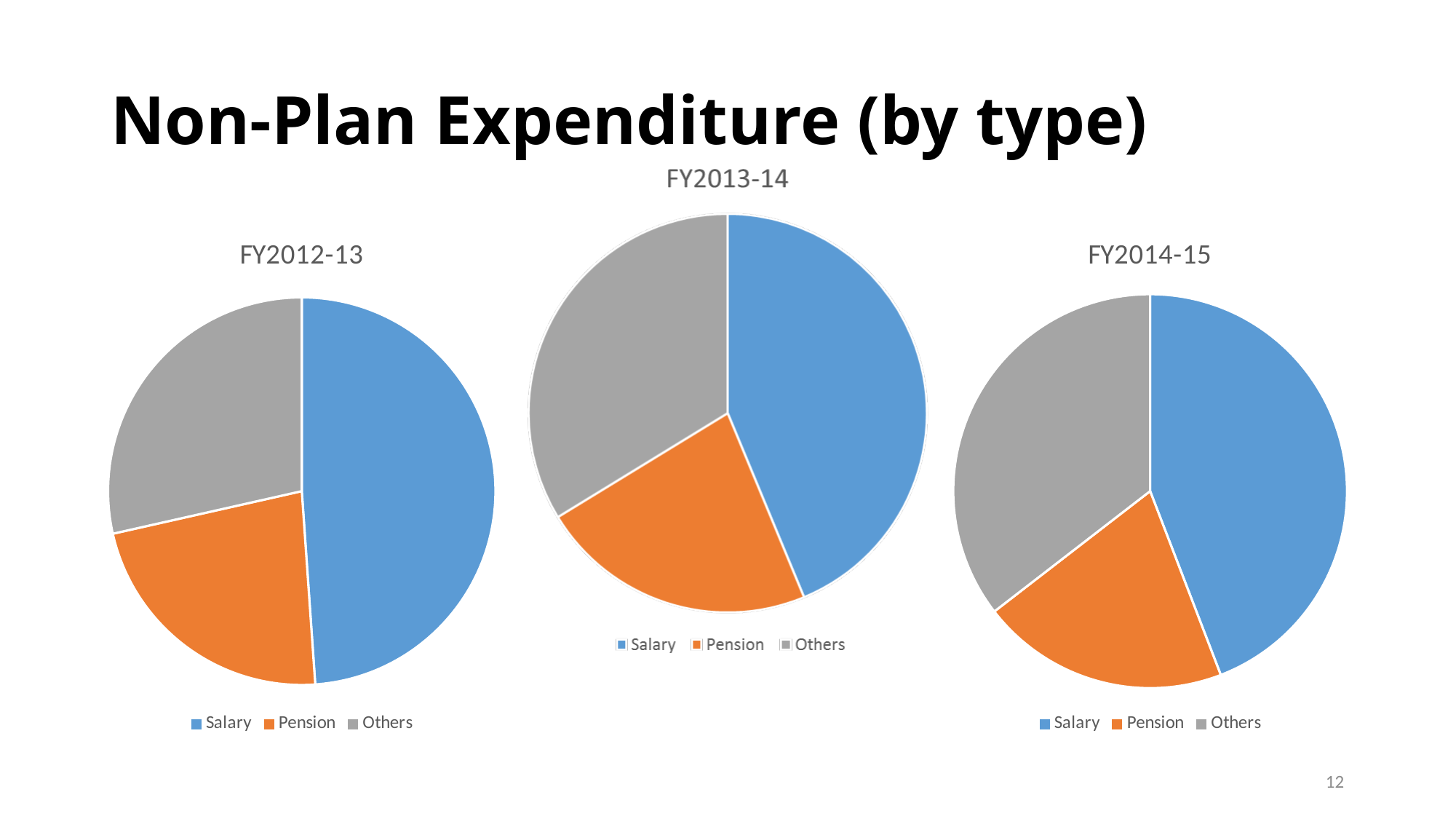
In the FY2014-15 chart, which category has the smallest slice? Pension In the FY2012-13 chart, which category has the largest slice? Salary In the FY2014-15 chart, which slice is larger, Others or Pension? Others What is the title of the middle pie chart on the slide? FY2013-14 In the FY2012-13 chart, which slice is larger, Salary or Others? Salary How many entries does the legend of the FY2014-15 chart list? 3 What colour is the Pension slice in the FY2013-14 chart? orange How many pie charts are shown on the slide? 3 In the FY2013-14 chart, which category has the smallest slice? Pension In the FY2013-14 chart, which category has the largest slice? Salary In the FY2013-14 chart, how many slices does the pie have? 3 What kind of chart is the FY2012-13 chart? pie chart